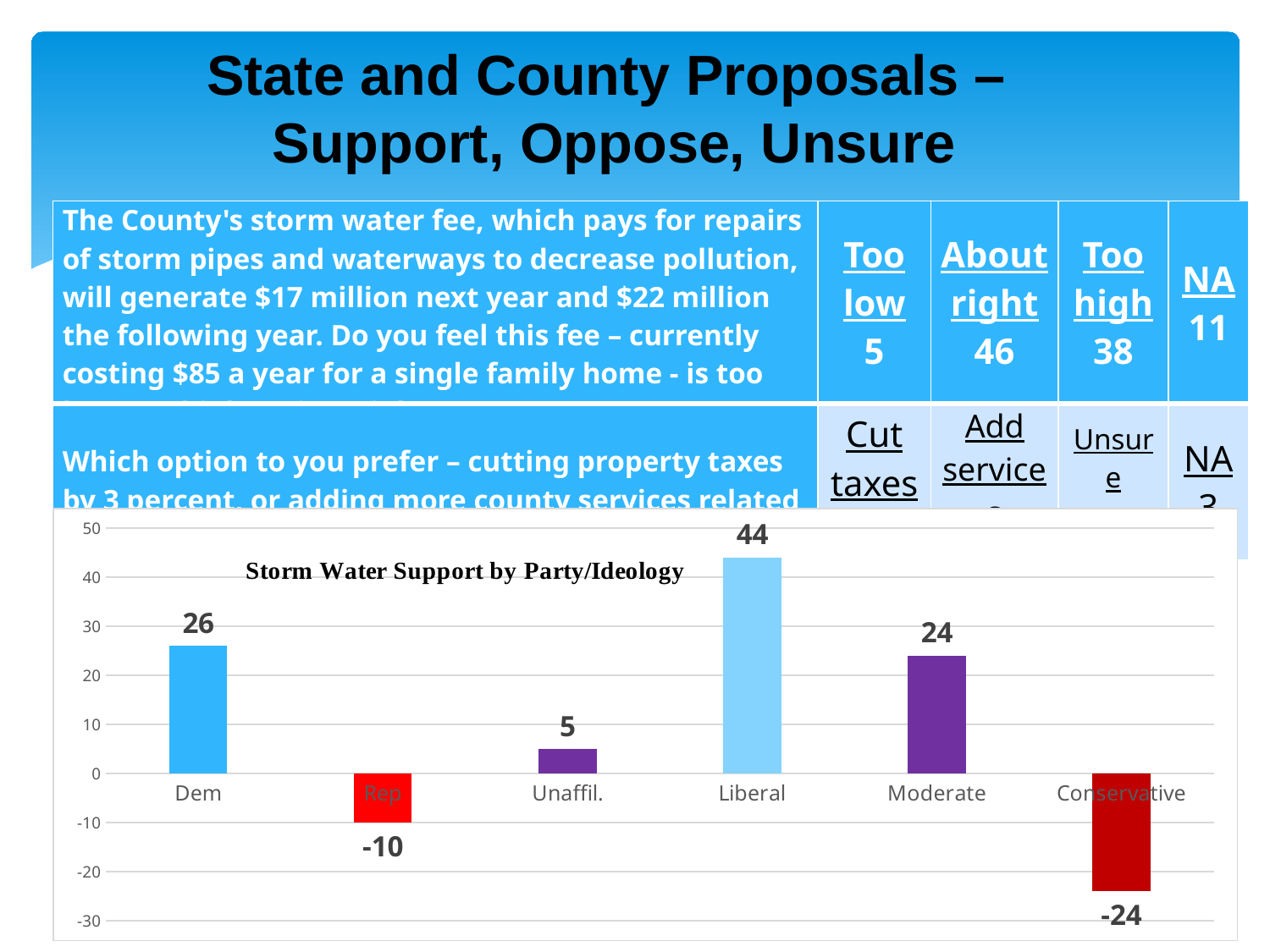
What is the value for Conservative in the Storm Water Support by Party/Ideology chart? -24 Which is larger, the value for Dem or the value for Unaffil.? Dem What is the value for Dem in the Storm Water Support by Party/Ideology chart? 26 Which category has the lowest value in the chart? Conservative What is the title of the chart? Storm Water Support by Party/Ideology Which category has the highest value in the chart? Liberal What is the value for Rep in the chart? -10 What is the difference between the values for Liberal and Moderate? 20 Is the value for Liberal greater or less than 40? greater What kind of chart is shown on the slide? bar chart How many categories are shown on the x axis of the chart? 6 How many categories in the chart have negative values? 2